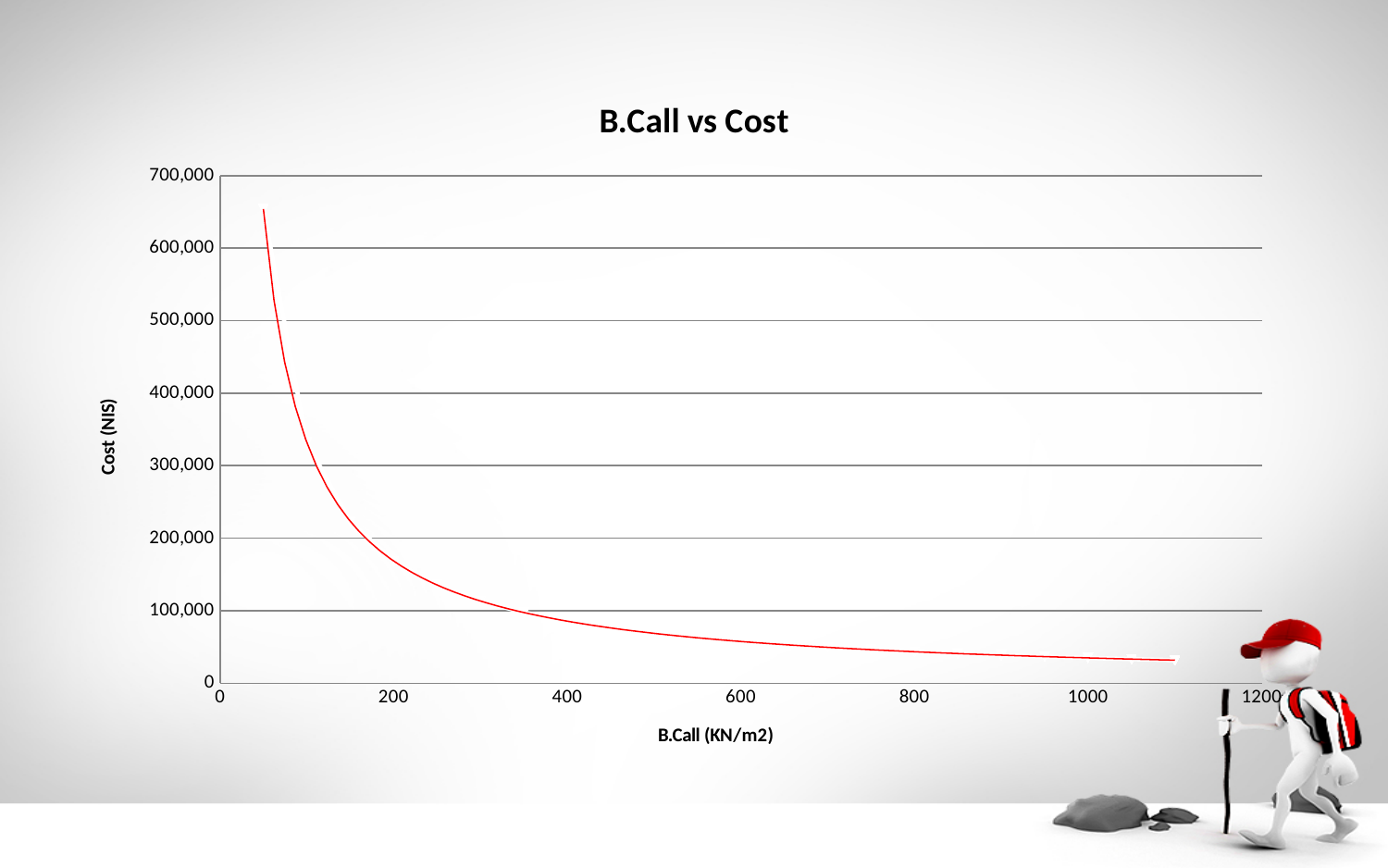
Is the cost at a B.Call of 200 greater or less than 400,000? less Is the cost higher at a B.Call of 200 or at a B.Call of 800? 200 Is the cost at a B.Call of 800 greater or less than 200,000? less Is the cost at a B.Call of 1000 greater or less than 100,000? less What kind of chart is shown on the slide? line chart What is the highest value shown on the vertical axis? 700,000 What is the label of the vertical axis? Cost (NIS) As B.Call increases along the x axis, does the cost rise or fall? fall How many lines are plotted on the chart? 1 What is the title of the chart? B.Call vs Cost